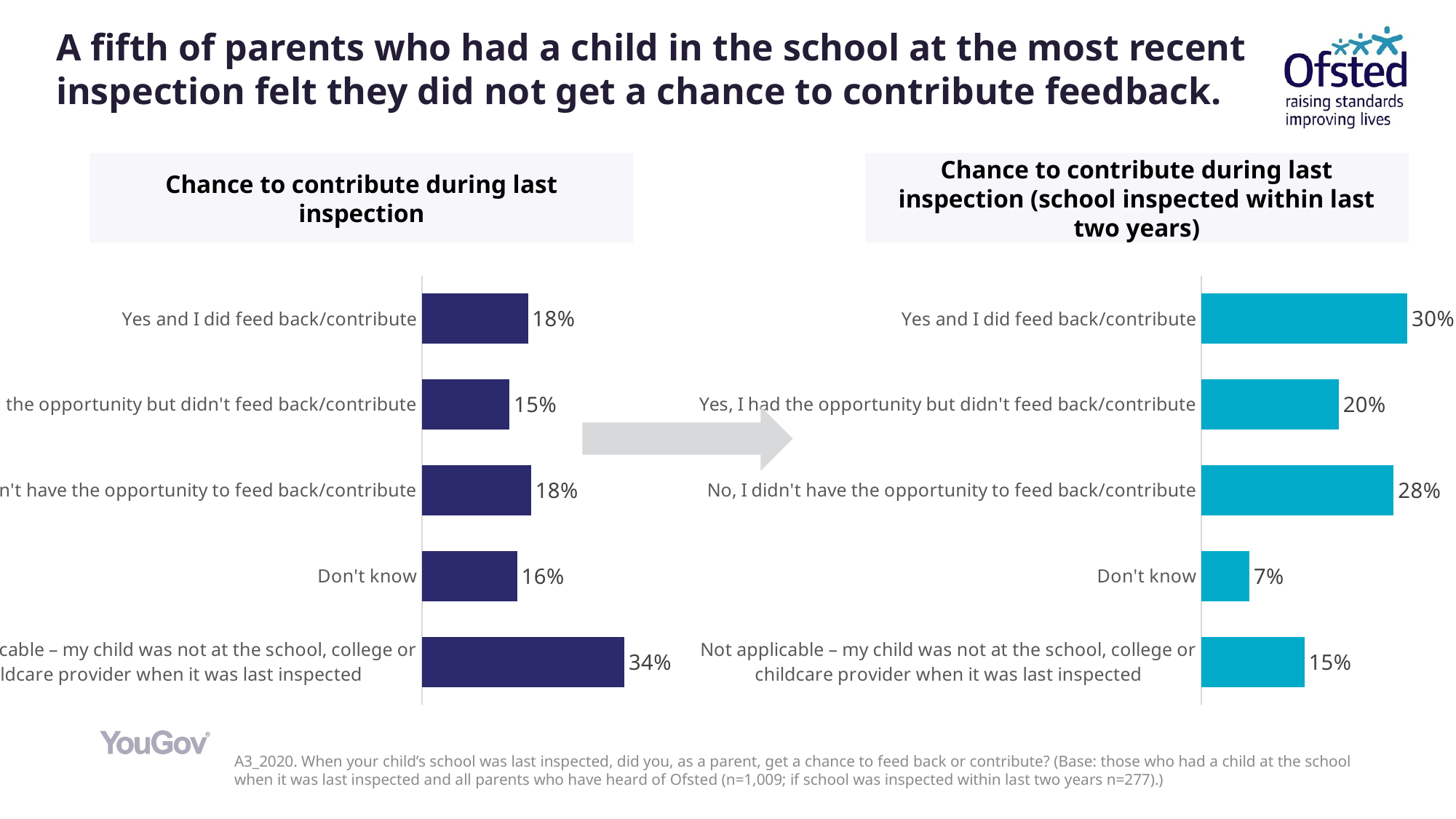
In the left chart, 'Chance to contribute during last inspection', what percentage of parents answered 'Don't know'? 16% What type of chart is the right chart, 'Chance to contribute during last inspection (school inspected within last two years)'? Bar chart In the right chart, 'Chance to contribute during last inspection (school inspected within last two years)', what percentage said 'No, I didn't have the opportunity to feed back/contribute'? 28% What is the difference between the 'Yes and I did feed back/contribute' value in the right chart and the same category in the left chart? 12 percentage points In the right chart, 'Chance to contribute during last inspection (school inspected within last two years)', which category has the highest value? Yes and I did feed back/contribute In the right chart, 'Chance to contribute during last inspection (school inspected within last two years)', which category has the lowest value? Don't know In the left chart, 'Chance to contribute during last inspection', what percentage of parents said 'Yes and I did feed back/contribute'? 18% How many categories are shown in the left chart, 'Chance to contribute during last inspection'? 5 In the left chart, 'Chance to contribute during last inspection', which category has the highest value? Not applicable – my child was not at the school, college or childcare provider when it was last inspected In the right chart, 'Chance to contribute during last inspection (school inspected within last two years)', what percentage said 'Yes and I did feed back/contribute'? 30% In the right chart, 'Chance to contribute during last inspection (school inspected within last two years)', which is larger: 'Yes, I had the opportunity but didn't feed back/contribute' or 'No, I didn't have the opportunity to feed back/contribute'? No, I didn't have the opportunity to feed back/contribute In the right chart, 'Chance to contribute during last inspection (school inspected within last two years)', what is the difference between 'Yes and I did feed back/contribute' and 'Don't know'? 23 percentage points